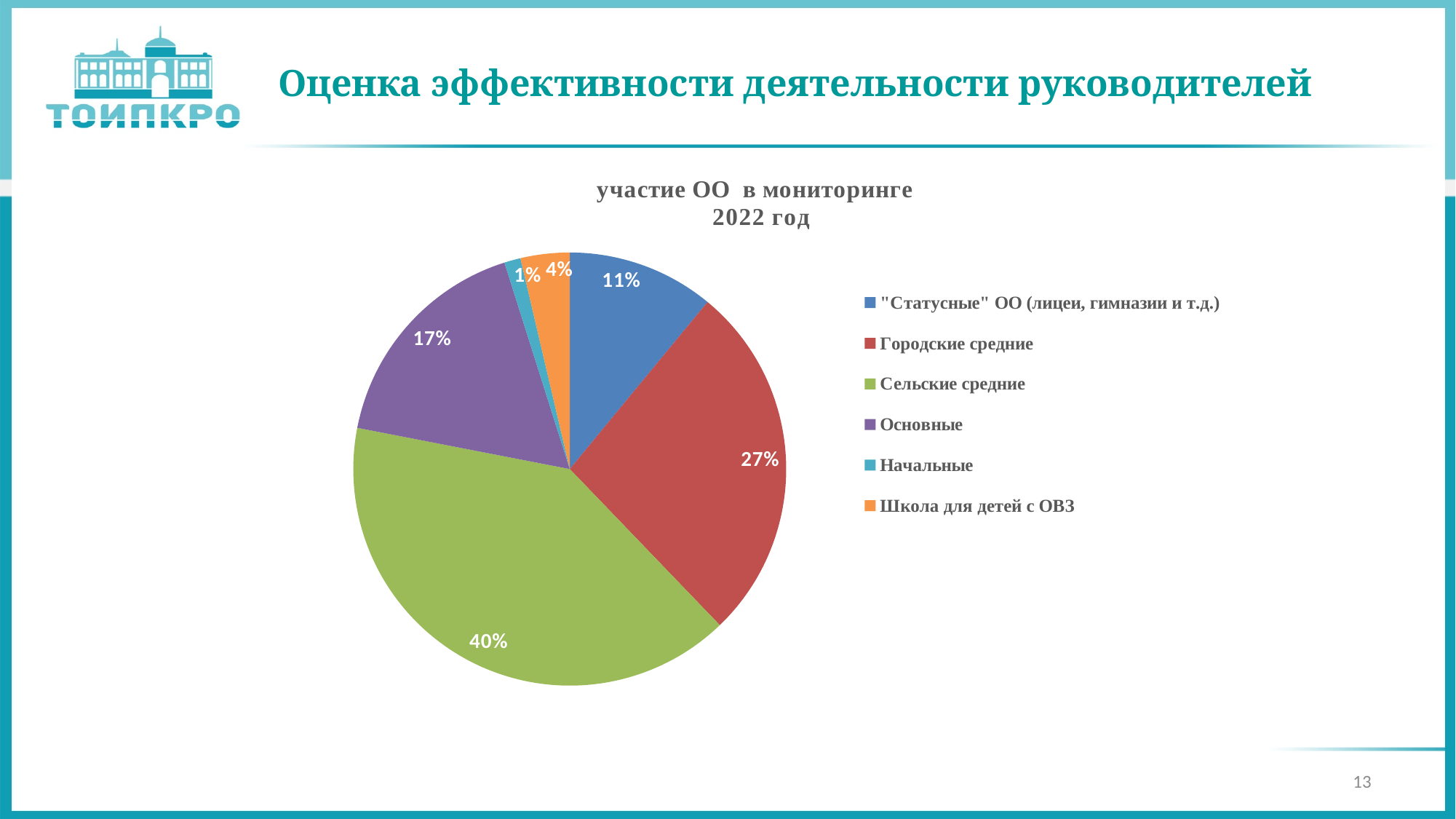
Which is larger, Основные or "Статусные" ОО (лицеи, гимназии и т.д.)? Основные What is the chart's title? участие ОО в мониторинге 2022 год Which category has the smallest slice? Начальные What is the difference between Сельские средние and Городские средние? 13% What is the value for "Статусные" ОО (лицеи, гимназии и т.д.)? 11% What kind of chart is shown on the slide? pie chart Which category has the largest slice? Сельские средние What is the value for Школа для детей с ОВЗ? 4% How many categories does the legend list? 6 What share of the pie does Сельские средние have? 40% What is the value for Основные? 17% What is the value for Городские средние? 27%